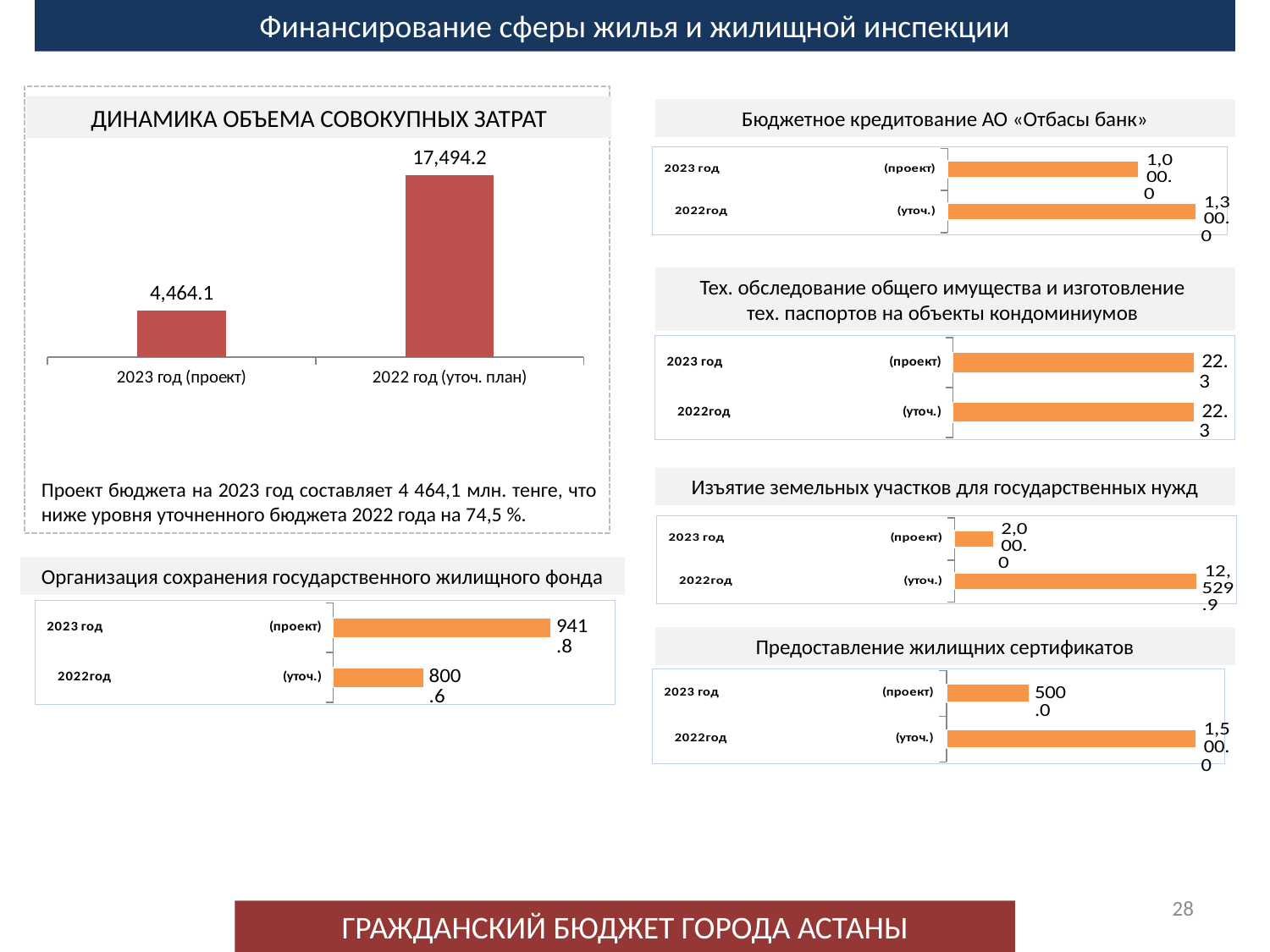
In the chart titled 'ДИНАМИКА ОБЪЕМА СОВОКУПНЫХ ЗАТРАТ', what kind of chart is shown? bar chart In the chart titled 'Предоставление жилищных сертификатов', how many categories are shown? 2 In the chart titled 'Организация сохранения государственного жилищного фонда', what is the value for 2023 год (проект)? 941.8 In the chart titled 'ДИНАМИКА ОБЪЕМА СОВОКУПНЫХ ЗАТРАТ', what is the value for 2022 год (уточ. план)? 17,494.2 In the chart titled 'Предоставление жилищных сертификатов', what is the value for 2023 год (проект)? 500.0 In the chart titled 'ДИНАМИКА ОБЪЕМА СОВОКУПНЫХ ЗАТРАТ', which category has the highest value? 2022 год (уточ. план) In the chart titled 'Бюджетное кредитование АО «Отбасы банк»', which is larger: 2023 год (проект) or 2022год (уточ.)? 2022год (уточ.) In the chart titled 'Тех. обследование общего имущества и изготовление тех. паспортов на объекты кондоминиумов', what is the value for 2023 год (проект)? 22.3 In the chart titled 'Организация сохранения государственного жилищного фонда', what is the difference between the 2023 год (проект) and 2022год (уточ.) values? 141.2 In the chart titled 'ДИНАМИКА ОБЪЕМА СОВОКУПНЫХ ЗАТРАТ', what is the value for 2023 год (проект)? 4,464.1 In the chart titled 'Изъятие земельных участков для государственных нужд', what is the value for 2022год (уточ.)? 12,529.9 In the chart titled 'Бюджетное кредитование АО «Отбасы банк»', what is the value for 2022год (уточ.)? 1,300.0